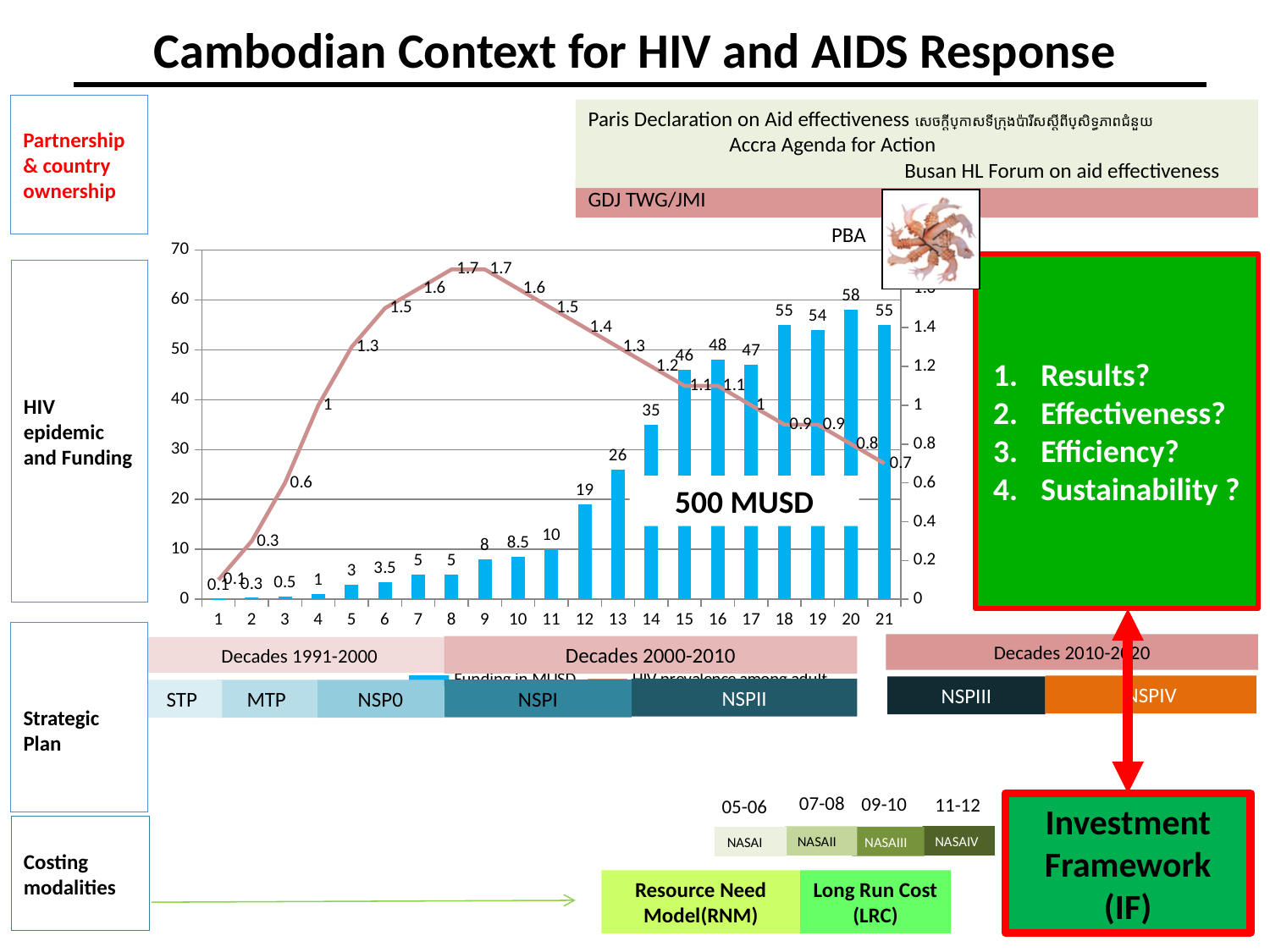
What is the HIV prevalence value shown for category 8? 1.7 Which category has the highest funding bar? 20 What is the funding value (in MUSD) for category 20? 58 What is the maximum value shown on the left vertical axis? 70 Which category has the lowest funding bar? 1 Do the funding bars generally rise or fall from category 1 to category 14? rise How many categories are shown on the x axis? 21 How many series does the legend list? 2 What is the funding value (in MUSD) for category 13? 26 What is the HIV prevalence value shown for category 21? 0.7 Which has a larger funding value, category 15 or category 16? 16 What is the difference in funding between category 20 and category 19? 4